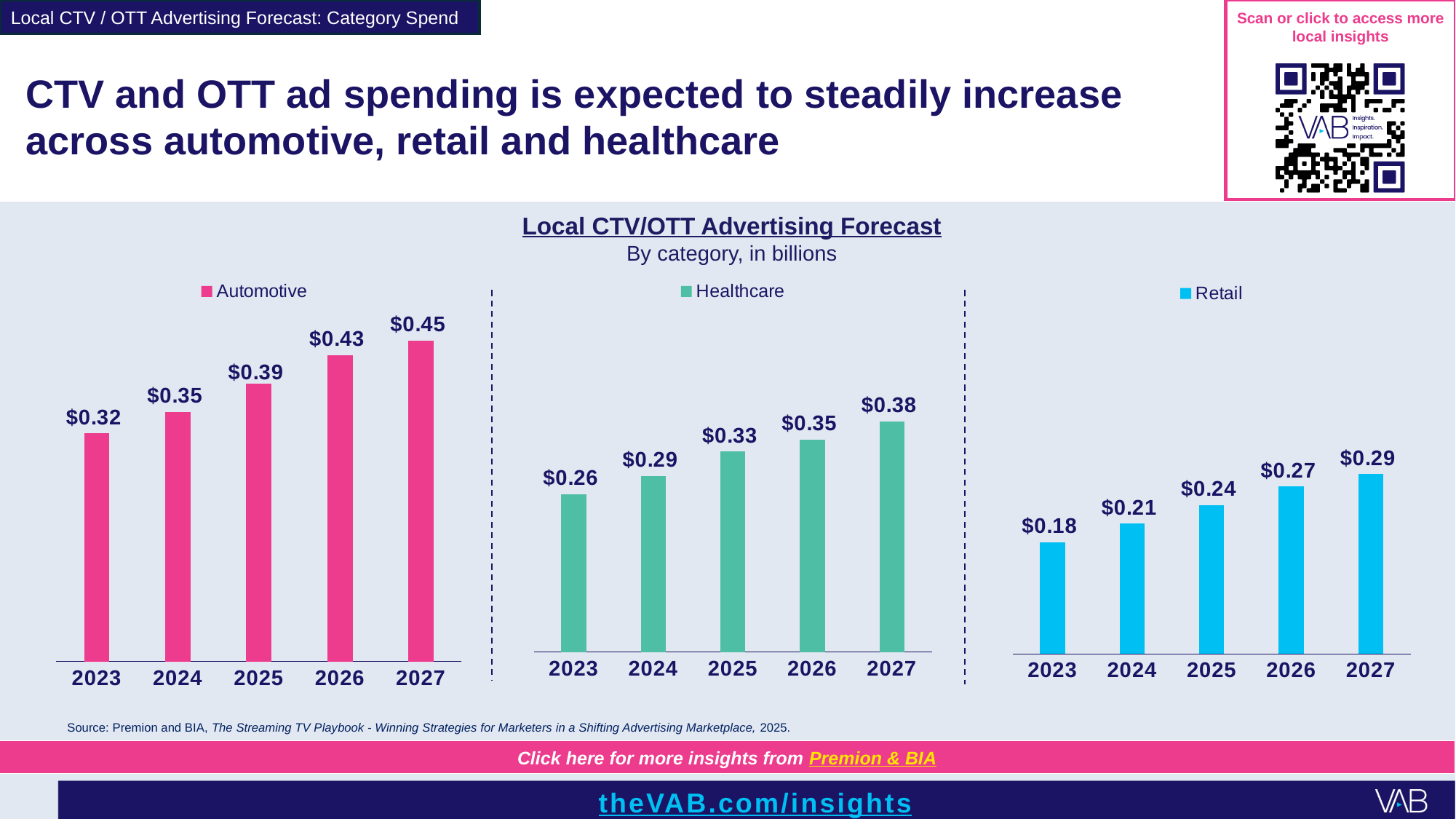
What kind of chart is the Healthcare chart? Bar chart In the Retail chart, which year has the lowest value? 2023 In the Automotive chart, which year has the highest value? 2027 In the Automotive chart, what is the difference between the 2026 and 2024 values? $0.08 How many years are shown in the Retail chart? 5 In the Healthcare chart, what is the value for 2025? $0.33 In the Healthcare chart, what is the difference between the 2027 and 2023 values? $0.12 Which is larger: the Healthcare value for 2027 or the Retail value for 2027? Healthcare In the Retail chart, what is the value for 2027? $0.29 In the Automotive chart, do the values rise or fall from 2023 to 2027? Rise In the Automotive chart, what is the value for 2023? $0.32 What is the title of the chart group on the slide? Local CTV/OTT Advertising Forecast